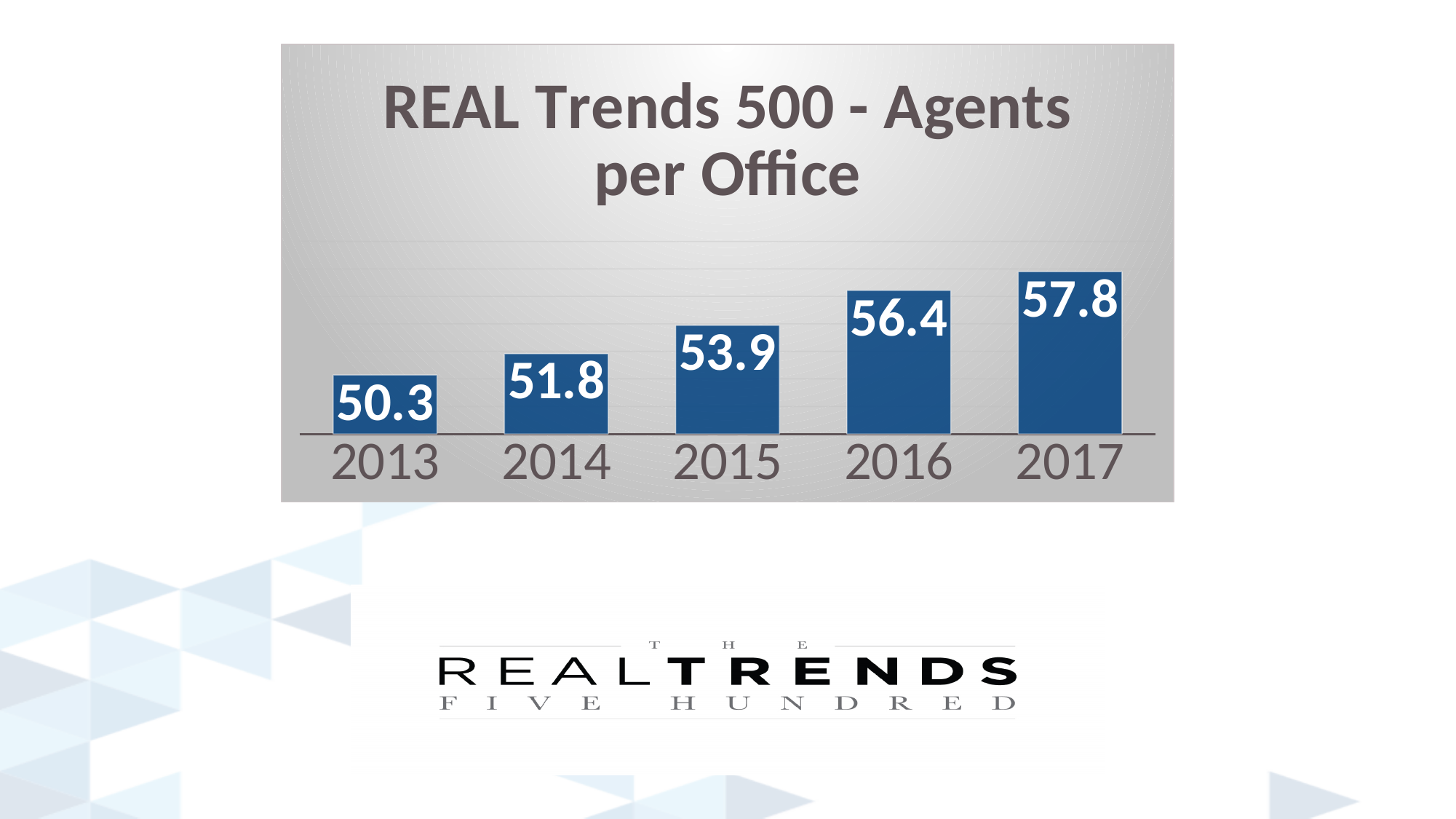
What kind of chart is this? bar chart What is the value for 2015? 53.9 What is the value for 2013? 50.3 Which year has the lowest agents per office? 2013 Do the values rise or fall from 2013 to 2017? rise What is the value for 2017? 57.8 Which year has the highest agents per office? 2017 What is the title of the chart? REAL Trends 500 - Agents per Office What is the difference between the values for 2017 and 2013? 7.5 Which is larger, the value for 2014 or the value for 2016? 2016 What is the difference between the values for 2016 and 2015? 2.5 How many years are shown on the chart? 5